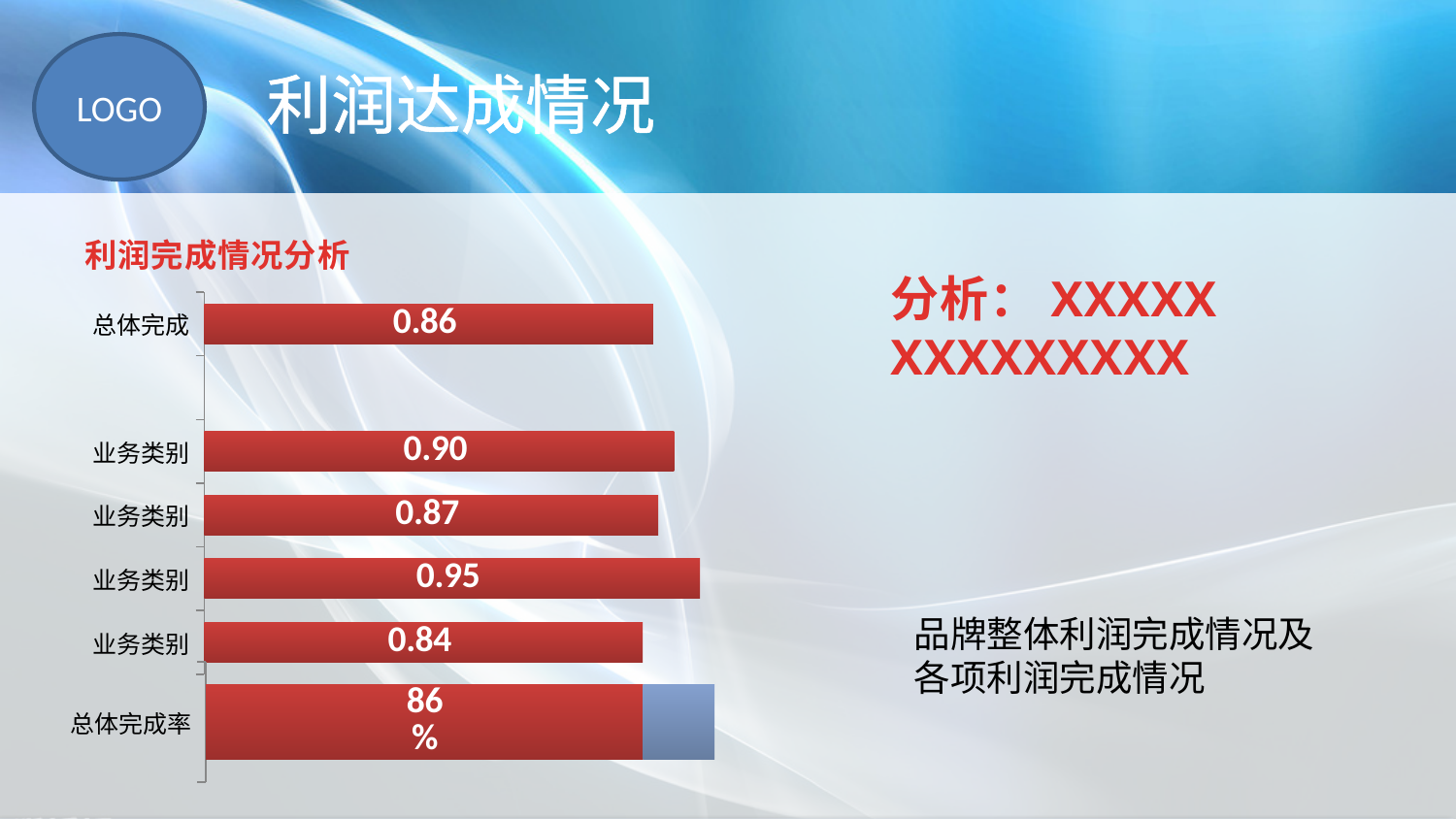
Which value is the lowest among the 业务类别 bars? 0.84 What colour are the data bars in the chart? Red What type of chart is shown on the slide? Bar chart What is the difference between the highest 业务类别 value (0.95) and the lowest 业务类别 value (0.84)? 0.11 What value is shown for 总体完成 in the 利润完成情况分析 chart? 0.86 What value is shown on the last 业务类别 bar (directly above 总体完成率)? 0.84 What is the title of the chart on the slide? 利润完成情况分析 Which is larger: the first 业务类别 bar (0.90) or the second 业务类别 bar (0.87)? 0.90 Which value is the highest among the 业务类别 bars? 0.95 What value is shown on the first 业务类别 bar (the second bar from the top)? 0.90 What value is labelled on the 总体完成率 bar? 86%